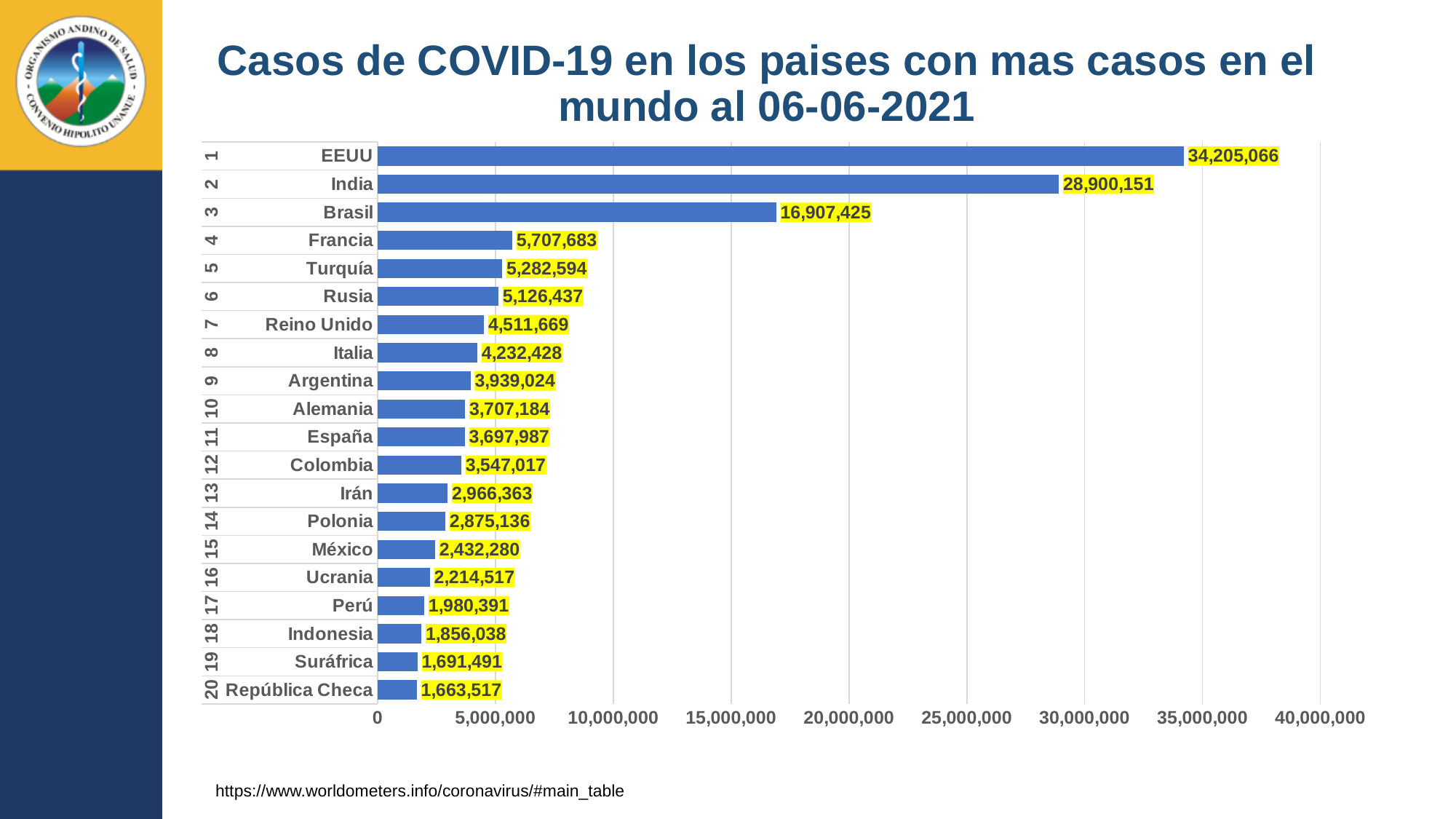
Is the value for Brasil greater or less than 15,000,000? greater How many COVID-19 cases does the chart show for India? 28,900,151 What kind of chart is shown on the slide? Bar chart Which country has the highest number of cases on the chart? EEUU What is the difference between the values for EEUU and India? 5,304,915 What is the value shown for Perú? 1,980,391 How many countries are listed on the chart? 20 What is the difference between the values for Perú and Indonesia? 124,353 What is the value shown for Colombia? 3,547,017 Which has more cases, Brasil or Francia? Brasil What is the title of the chart? Casos de COVID-19 en los paises con mas casos en el mundo al 06-06-2021 Which country has the lowest number of cases on the chart? República Checa